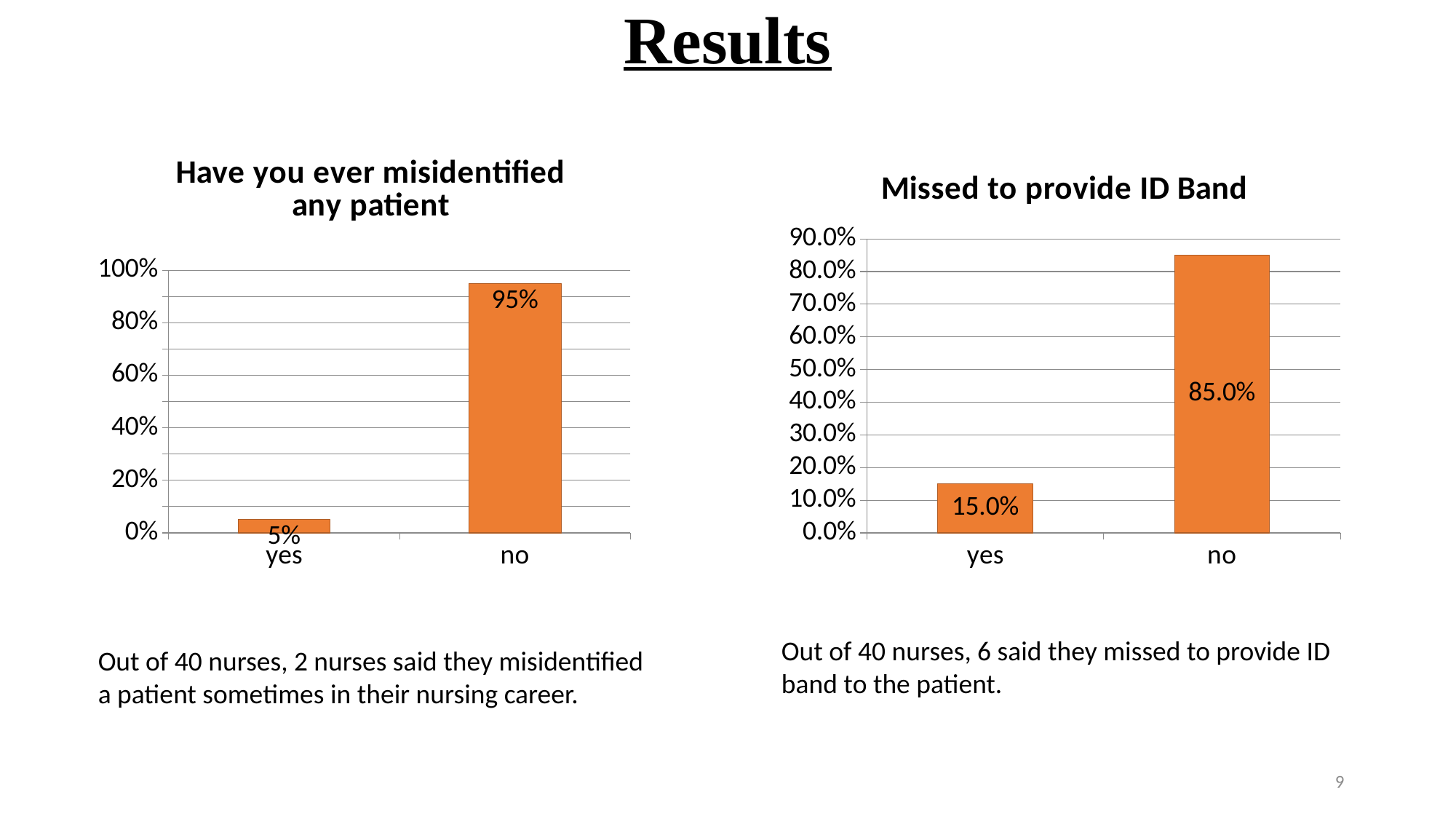
In the chart titled "Have you ever misidentified any patient", is the value for "no" greater or less than 80%? greater In the chart titled "Have you ever misidentified any patient", what is the value for "no"? 95% In the chart titled "Missed to provide ID Band", what is the value for "yes"? 15.0% In the chart titled "Missed to provide ID Band", what is the difference between the values for "no" and "yes"? 70.0% In the chart titled "Have you ever misidentified any patient", which category has the highest value? no In the chart titled "Missed to provide ID Band", which category has the lowest value? yes What kind of chart is the chart titled "Have you ever misidentified any patient"? bar chart In the chart titled "Have you ever misidentified any patient", what is the difference between the values for "no" and "yes"? 90% In the chart titled "Missed to provide ID Band", what is the value for "no"? 85.0% In the chart titled "Have you ever misidentified any patient", what is the value for "yes"? 5% In the chart titled "Missed to provide ID Band", which is larger, the value for "yes" or the value for "no"? no How many categories are shown in the chart titled "Missed to provide ID Band"? 2